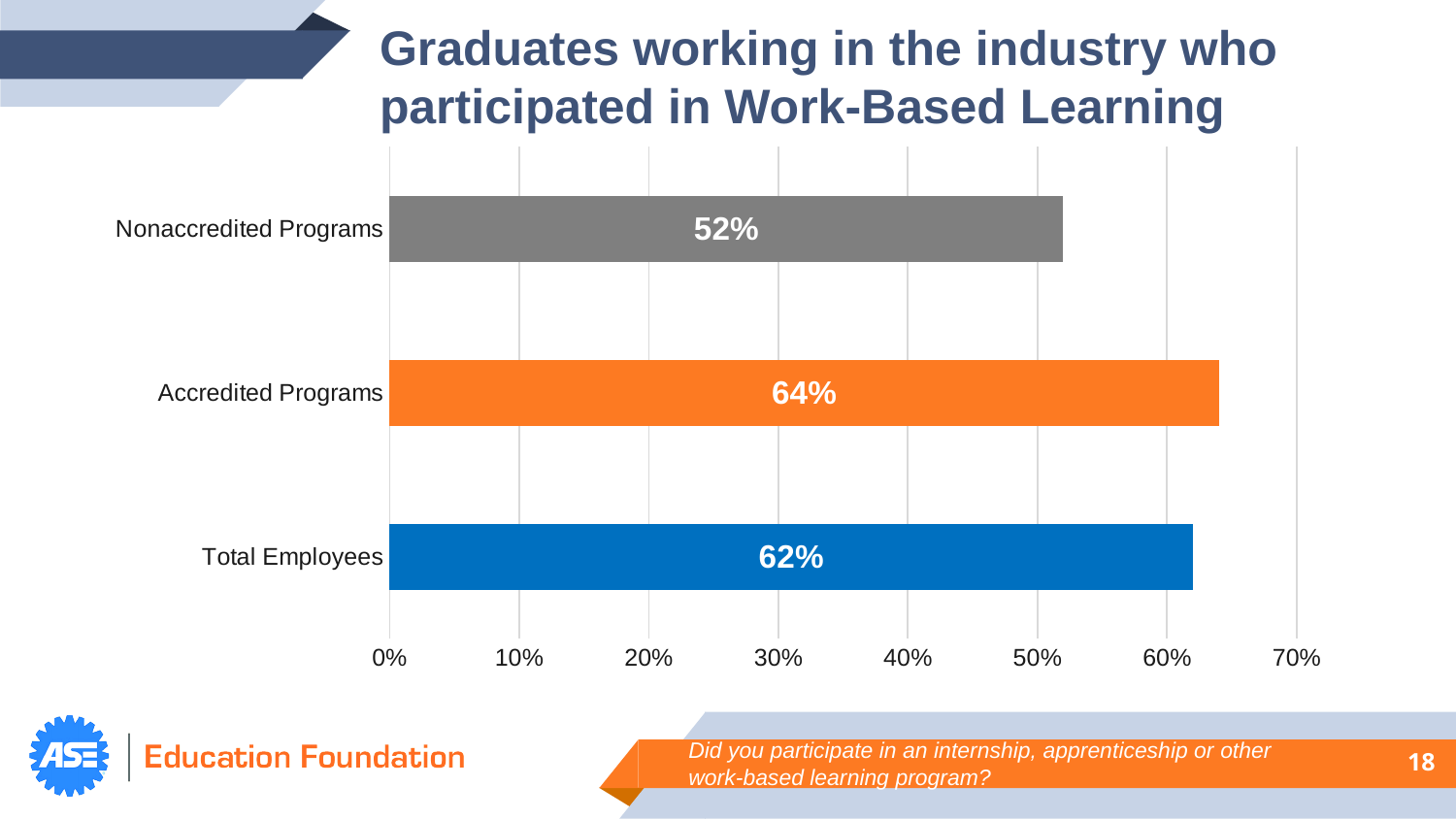
Which is larger: the value for Accredited Programs or Total Employees? Accredited Programs Which category has the lowest value? Nonaccredited Programs Is the value for Nonaccredited Programs greater or less than 60%? less Which category has the highest value? Accredited Programs What kind of chart is shown on the slide? Bar chart What colour is the bar for Accredited Programs? Orange What is the difference between the Accredited Programs and Nonaccredited Programs values? 12% What is the difference between the Total Employees and Nonaccredited Programs values? 10% What is the value shown for Nonaccredited Programs? 52% What is the value shown for Accredited Programs? 64% How many categories are shown in the chart? 3 What percentage of Total Employees participated in Work-Based Learning? 62%